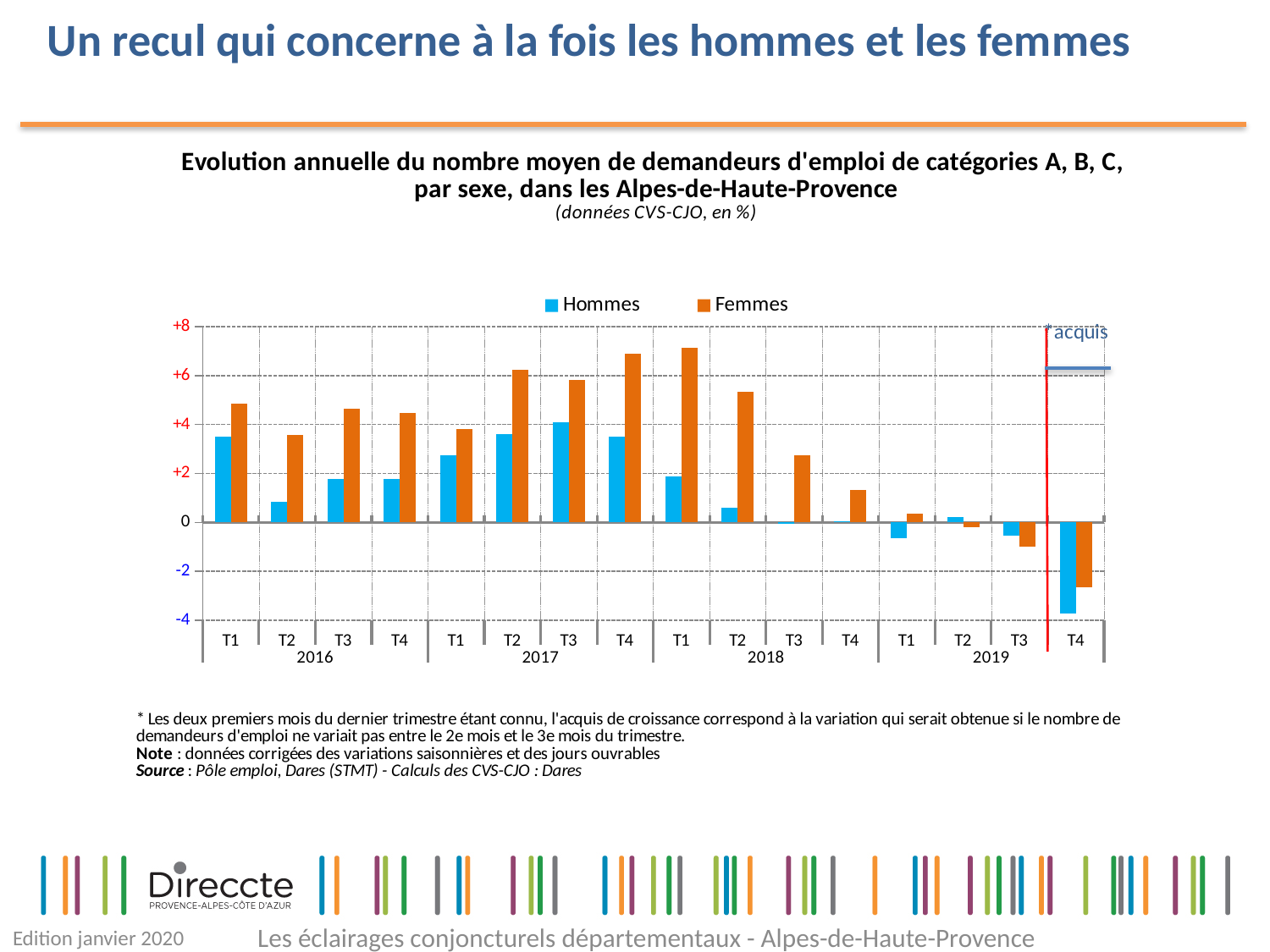
Is the value for Hommes in T2 2016 greater or less than +2? less Is the value for Femmes in T1 2016 greater or less than +4? greater Which quarter has the lowest value for Hommes? T4 2019 Which colour represents the Femmes series in the legend? orange How many series does the legend list? 2 Which quarter has the lowest value for Femmes? T4 2019 What kind of chart is shown on the slide? bar chart Is the value for Hommes in T4 2019 greater or less than -2? less In T1 2016, which series has the larger value, Hommes or Femmes? Femmes Do the Femmes values rise or fall from T1 2018 to T4 2019? fall Which quarter has the highest value for Hommes? T3 2017 How many quarters (categories) are plotted along the x axis? 16